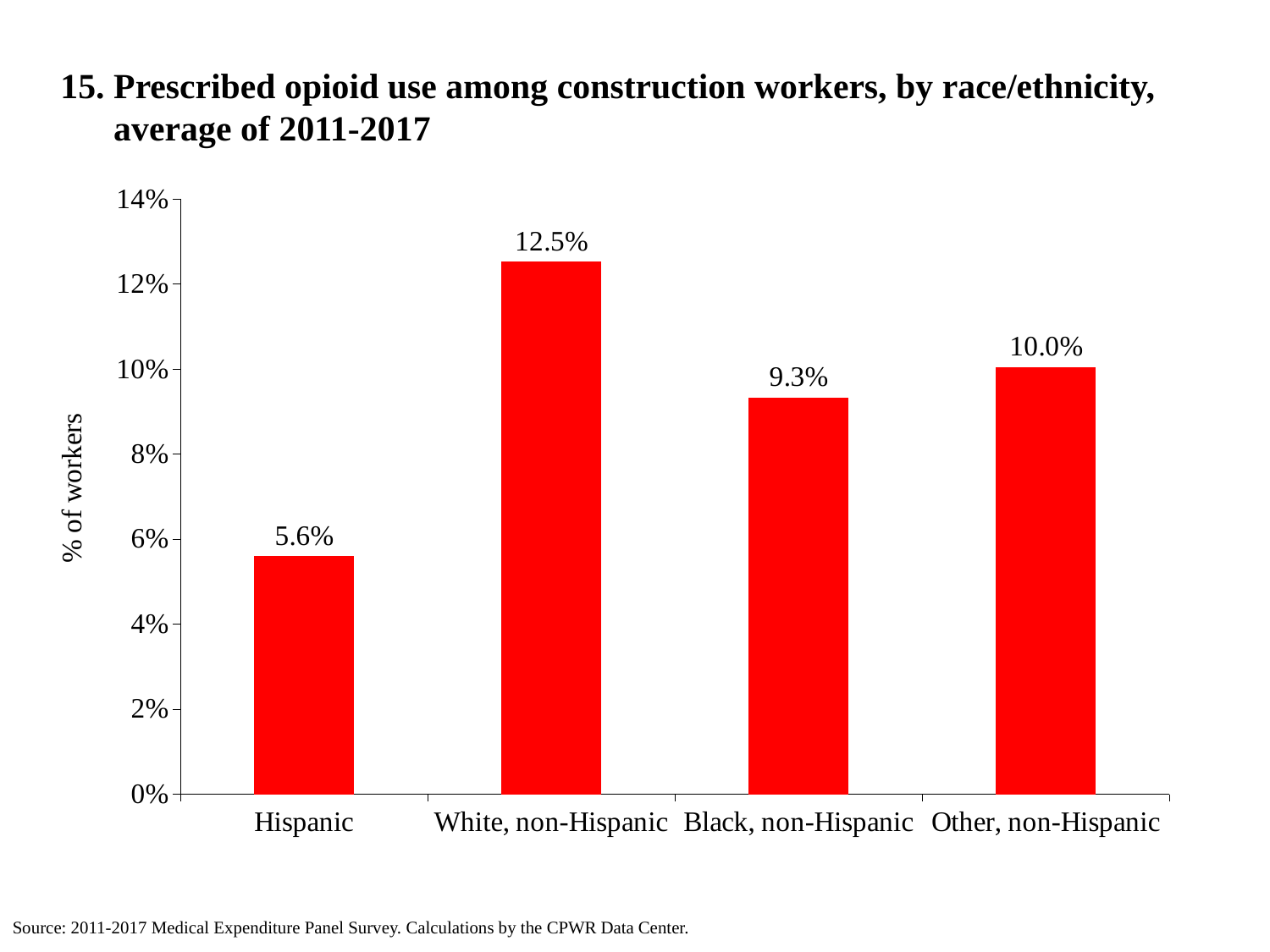
What type of chart is shown on the slide? Bar chart Which race/ethnicity group has the highest prescribed opioid use? White, non-Hispanic Which group has a higher value: Black, non-Hispanic or Other, non-Hispanic? Other, non-Hispanic What is the value shown for Other, non-Hispanic construction workers? 10.0% What is the value shown for Black, non-Hispanic construction workers? 9.3% What is the label of the vertical axis? % of workers Is the value for Black, non-Hispanic workers greater or less than 10%? less What is the difference in percentage points between White, non-Hispanic and Hispanic workers? 6.9 percentage points What is the value shown for White, non-Hispanic construction workers? 12.5% How many race/ethnicity categories are shown in the chart? 4 Which race/ethnicity group has the lowest prescribed opioid use? Hispanic What is the percentage of prescribed opioid use among Hispanic construction workers? 5.6%